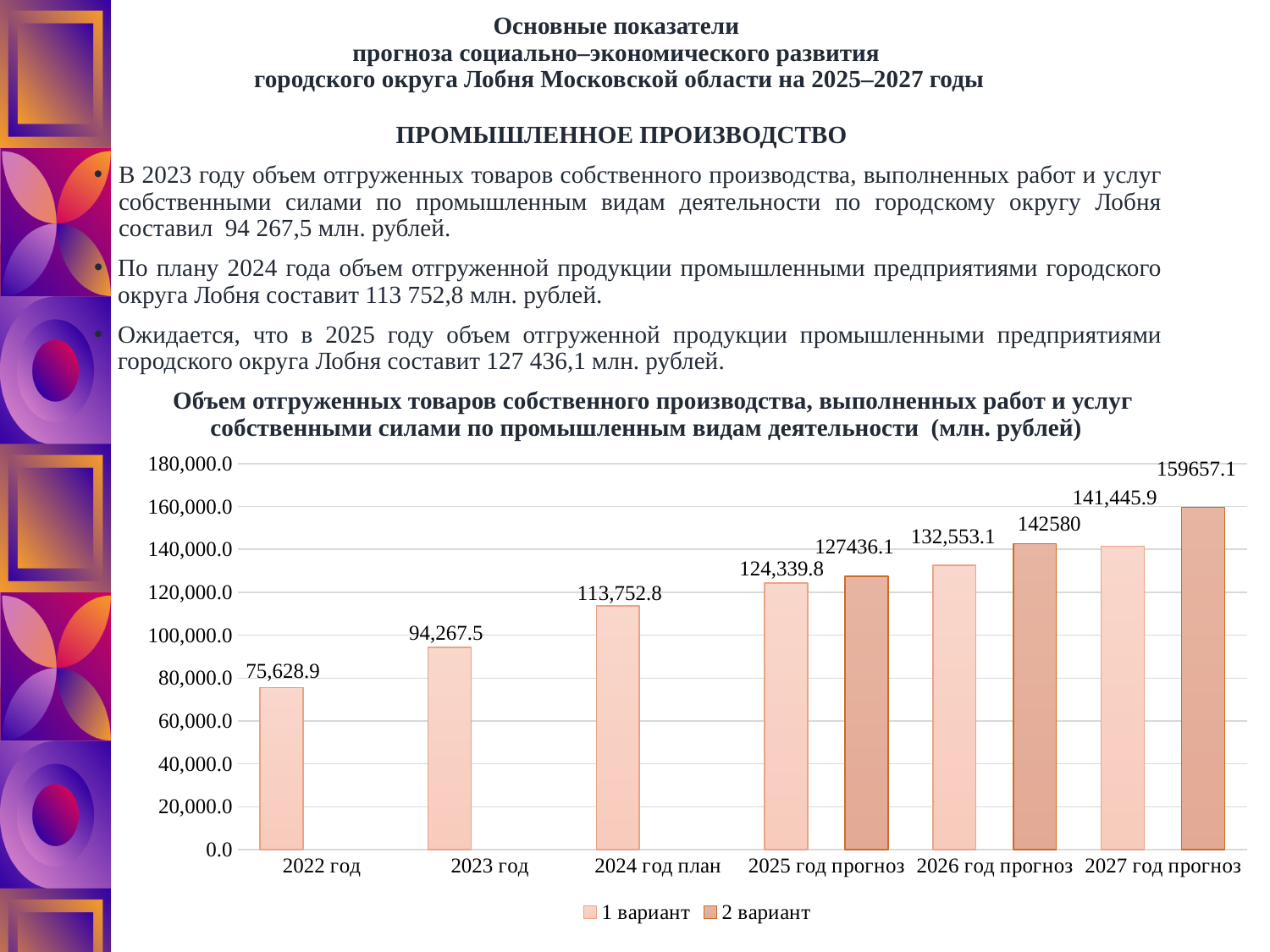
Do the values of 1 вариант rise or fall from 2022 год to 2027 год прогноз? rise What is the value of 1 вариант for 2026 год прогноз? 132,553.1 What is the difference between the values for 2023 год and 2022 год? 18,638.6 What type of chart is shown on the slide? bar chart How many series does the legend list? 2 Which category has the lowest value in the chart? 2022 год What is the value for 2024 год план? 113,752.8 What is the value for 2022 год? 75,628.9 What is the difference between 2 вариант and 1 вариант for 2027 год прогноз? 18,211.2 What is the value of 2 вариант for 2025 год прогноз? 127436.1 Which bar has the highest value in the chart? 2 вариант for 2027 год прогноз Which is larger for 2026 год прогноз: 1 вариант or 2 вариант? 2 вариант